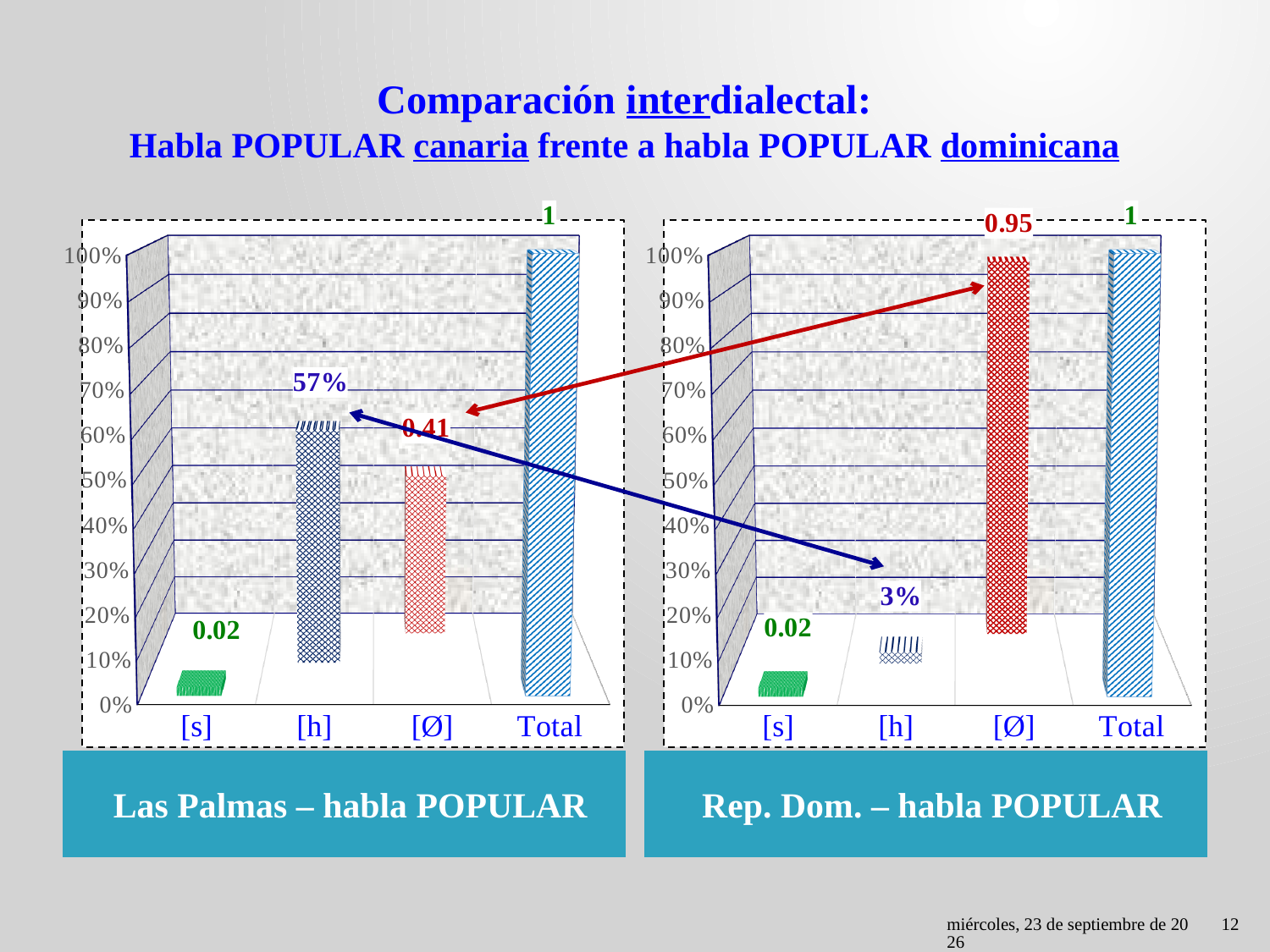
What is the difference between the [Ø] value in the Rep. Dom. – habla POPULAR chart and the [Ø] value in the Las Palmas – habla POPULAR chart? 0.54 In the Rep. Dom. – habla POPULAR chart, what is the value for [h]? 3% In the Las Palmas – habla POPULAR chart, is the value for [h] greater or less than 50%? greater In the Las Palmas – habla POPULAR chart, which category other than Total has the highest value? [h] In the Rep. Dom. – habla POPULAR chart, which category has the lowest value? [s] How many categories are shown on the x axis of the Las Palmas – habla POPULAR chart? 4 In the Las Palmas – habla POPULAR chart, what is the value for [Ø]? 0.41 In the Rep. Dom. – habla POPULAR chart, what is the value for [Ø]? 0.95 What kind of chart is the Rep. Dom. – habla POPULAR chart? bar chart In the Rep. Dom. – habla POPULAR chart, what is the value for [s]? 0.02 Which chart has the larger value for [Ø], Las Palmas – habla POPULAR or Rep. Dom. – habla POPULAR? Rep. Dom. – habla POPULAR In the Las Palmas – habla POPULAR chart, what is the value for [h]? 57%